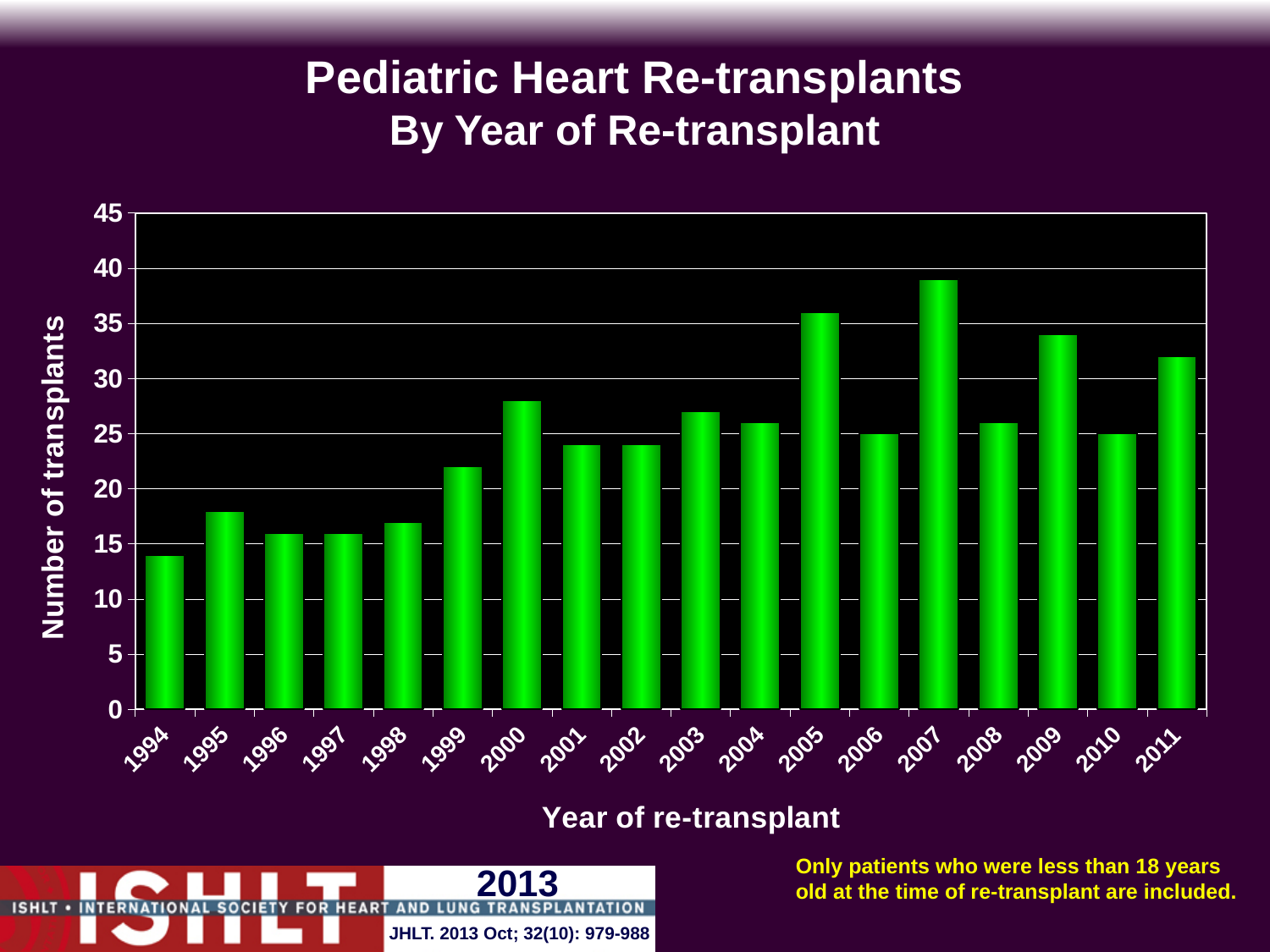
How many years are shown on the x axis of the chart? 18 Which year had more re-transplants, 2005 or 2006? 2005 Which year has the highest number of pediatric heart re-transplants? 2007 What is the label of the y axis of the chart? Number of transplants Is the number of re-transplants in 1994 greater or less than 15? less Overall, do the number of re-transplants rise or fall from 1994 to 2011? rise Is the number of re-transplants in 1999 greater or less than 25? less Which year had more re-transplants, 2000 or 1998? 2000 Which year has the lowest number of pediatric heart re-transplants? 1994 Is the number of re-transplants in 2005 greater or less than 30? greater What kind of chart is shown on the slide? bar chart